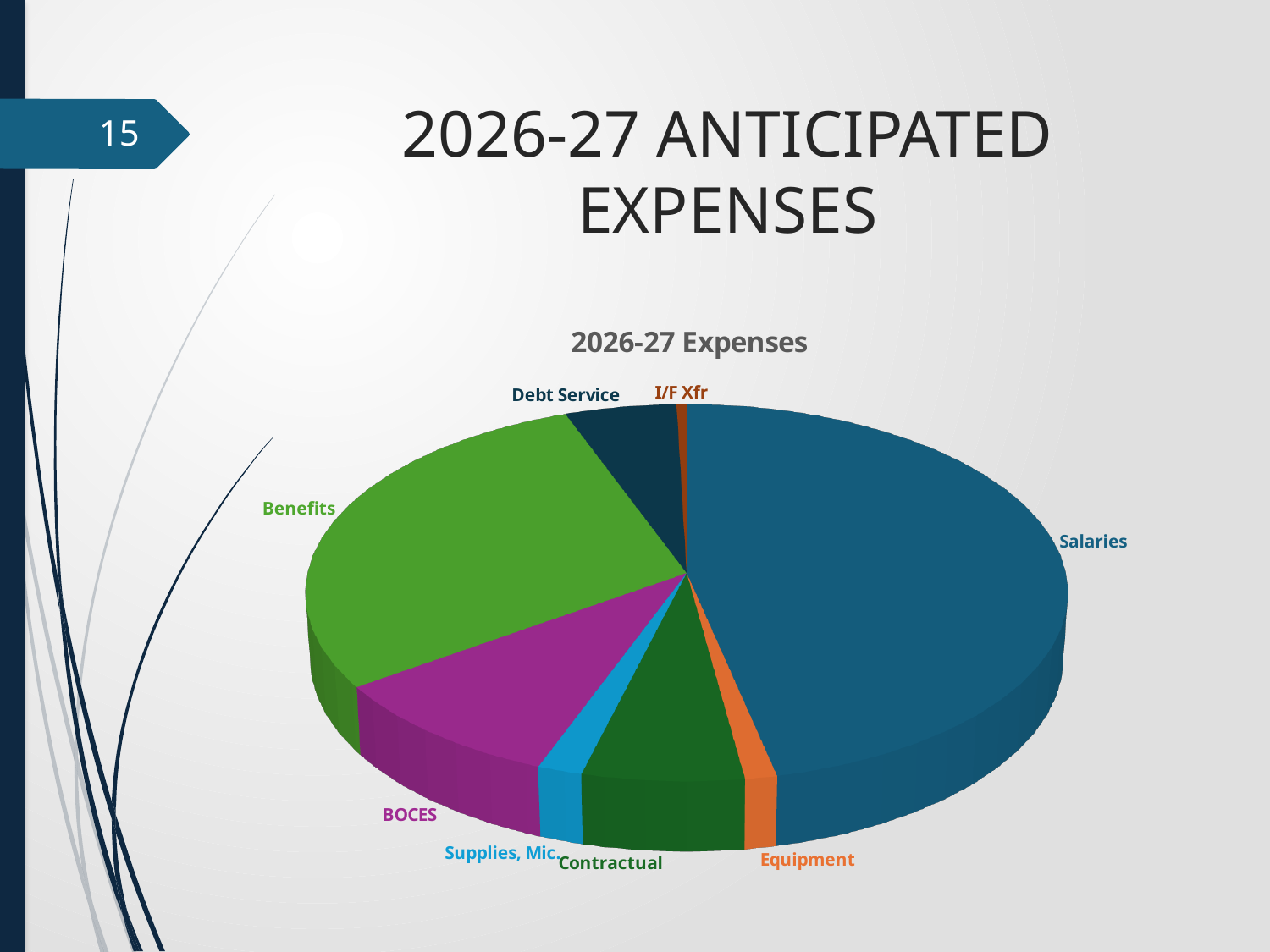
Which slice is larger, Benefits or BOCES? Benefits Which slice is larger, BOCES or I/F Xfr? BOCES What colour is the Salaries slice? blue Which slice is larger, Contractual or Supplies, Mic.? Contractual How many categories (slices) does the pie chart have? 8 What kind of chart is shown on the slide? pie chart What is the title of the chart? 2026-27 Expenses Which category has the smallest slice of the pie? I/F Xfr Which category has the largest slice of the pie? Salaries